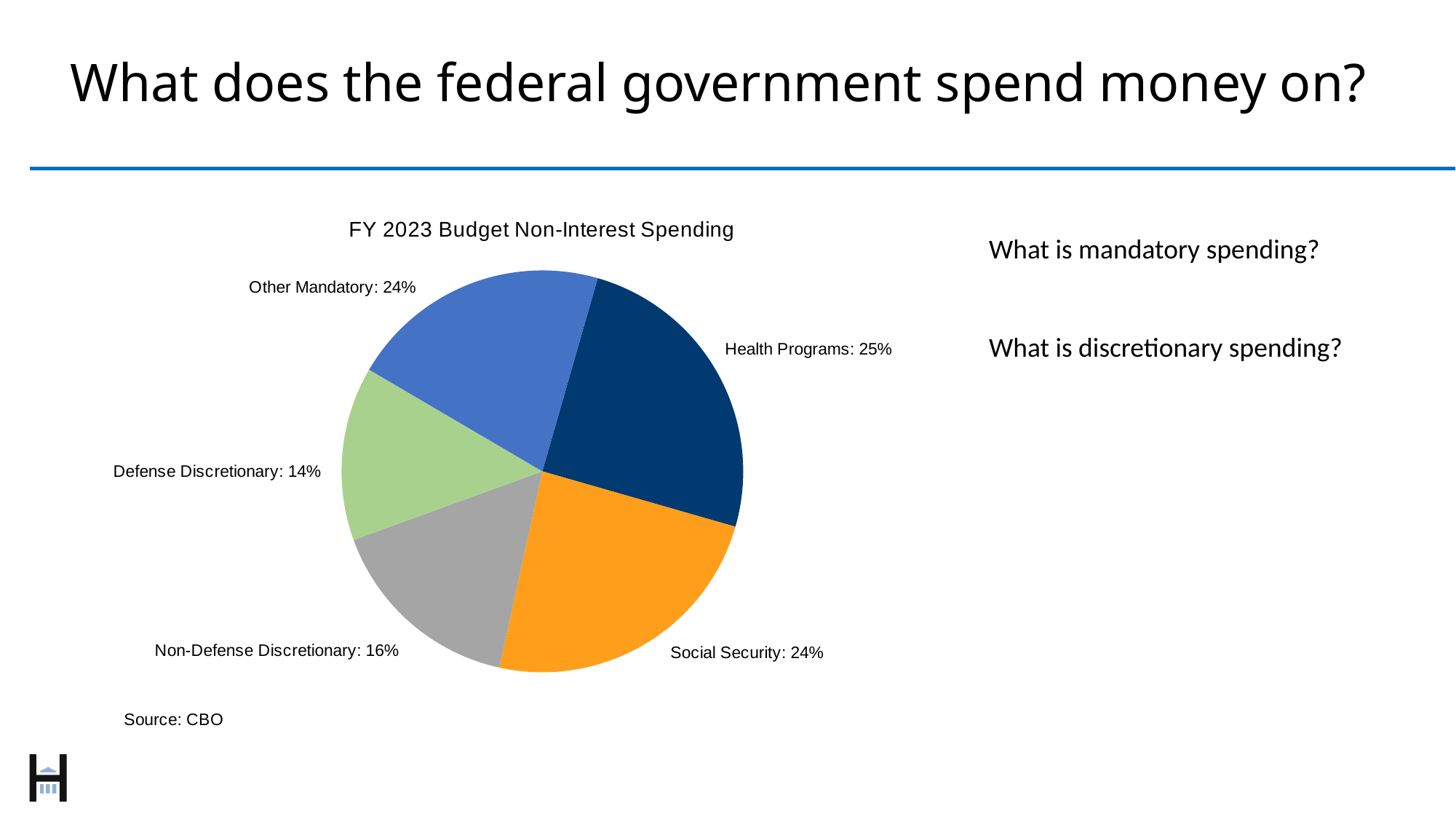
Which is larger, Non-Defense Discretionary or Defense Discretionary? Non-Defense Discretionary What type of chart is shown on the slide? Pie chart Which category has the smallest share of the pie? Defense Discretionary What share does Social Security represent in the pie chart? 24% What is the difference in percentage points between Health Programs and Defense Discretionary? 11 What is the value shown for Non-Defense Discretionary? 16% Which category has the largest share of the pie? Health Programs What percentage of the pie is Defense Discretionary? 14% How many slices does the pie chart have? 5 What is the title of the chart? FY 2023 Budget Non-Interest Spending What is the source cited for the chart? CBO What share of FY 2023 Budget Non-Interest Spending goes to Health Programs? 25%